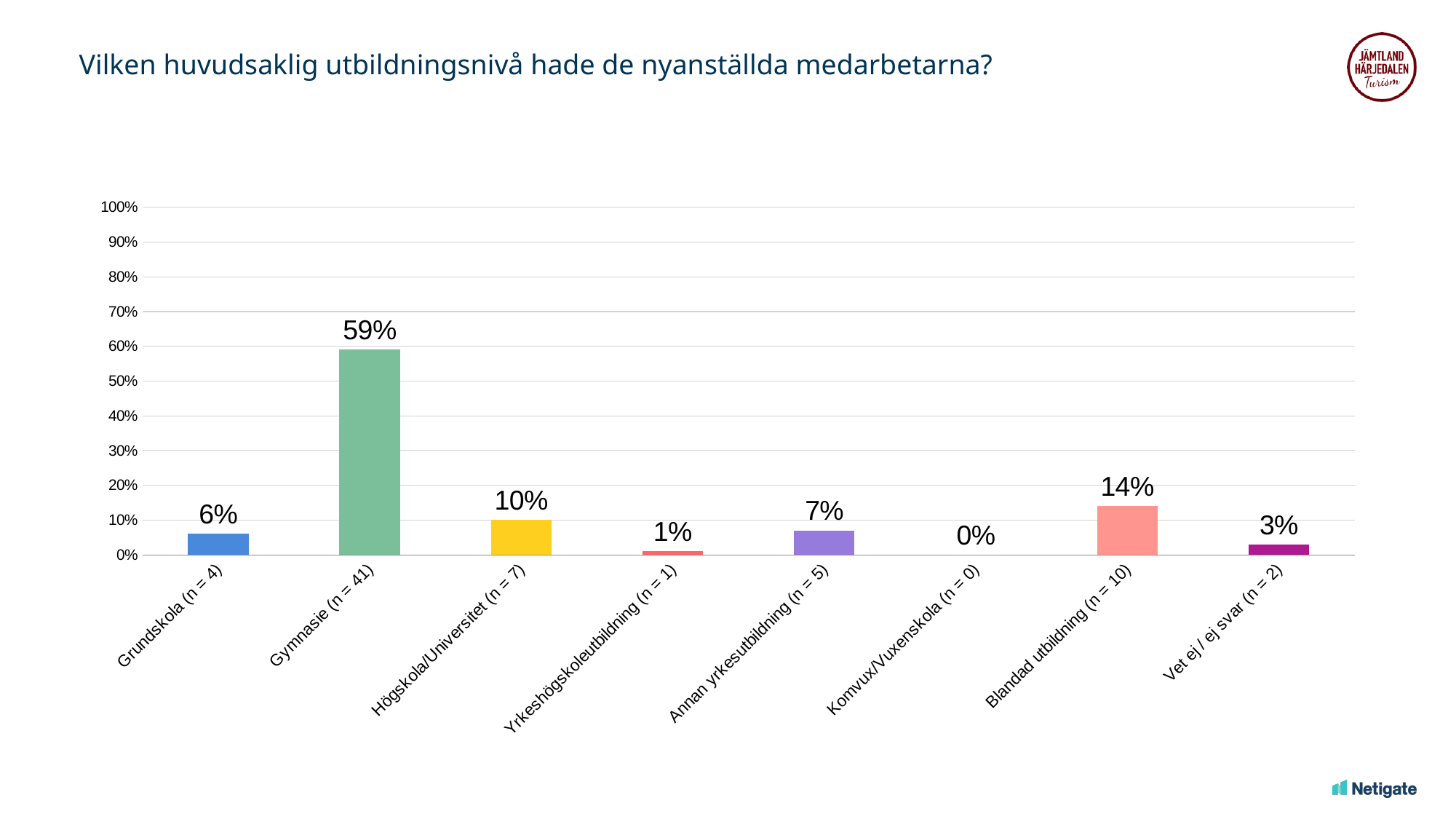
What is the value for Komvux/Vuxenskola (n = 0)? 0% Is the value for Gymnasie (n = 41) greater or less than 50%? greater What is the title of the chart? Vilken huvudsaklig utbildningsnivå hade de nyanställda medarbetarna? What kind of chart is shown on the slide? bar chart Which category has the highest value? Gymnasie (n = 41) What is the value for Högskola/Universitet (n = 7)? 10% How many categories are shown on the x axis? 8 Which is larger, the value for Grundskola (n = 4) or the value for Annan yrkesutbildning (n = 5)? Annan yrkesutbildning (n = 5) What is the value for Blandad utbildning (n = 10)? 14% What is the difference between the values for Gymnasie (n = 41) and Blandad utbildning (n = 10)? 45% Which category has the lowest value? Komvux/Vuxenskola (n = 0) What is the value for Gymnasie (n = 41)? 59%